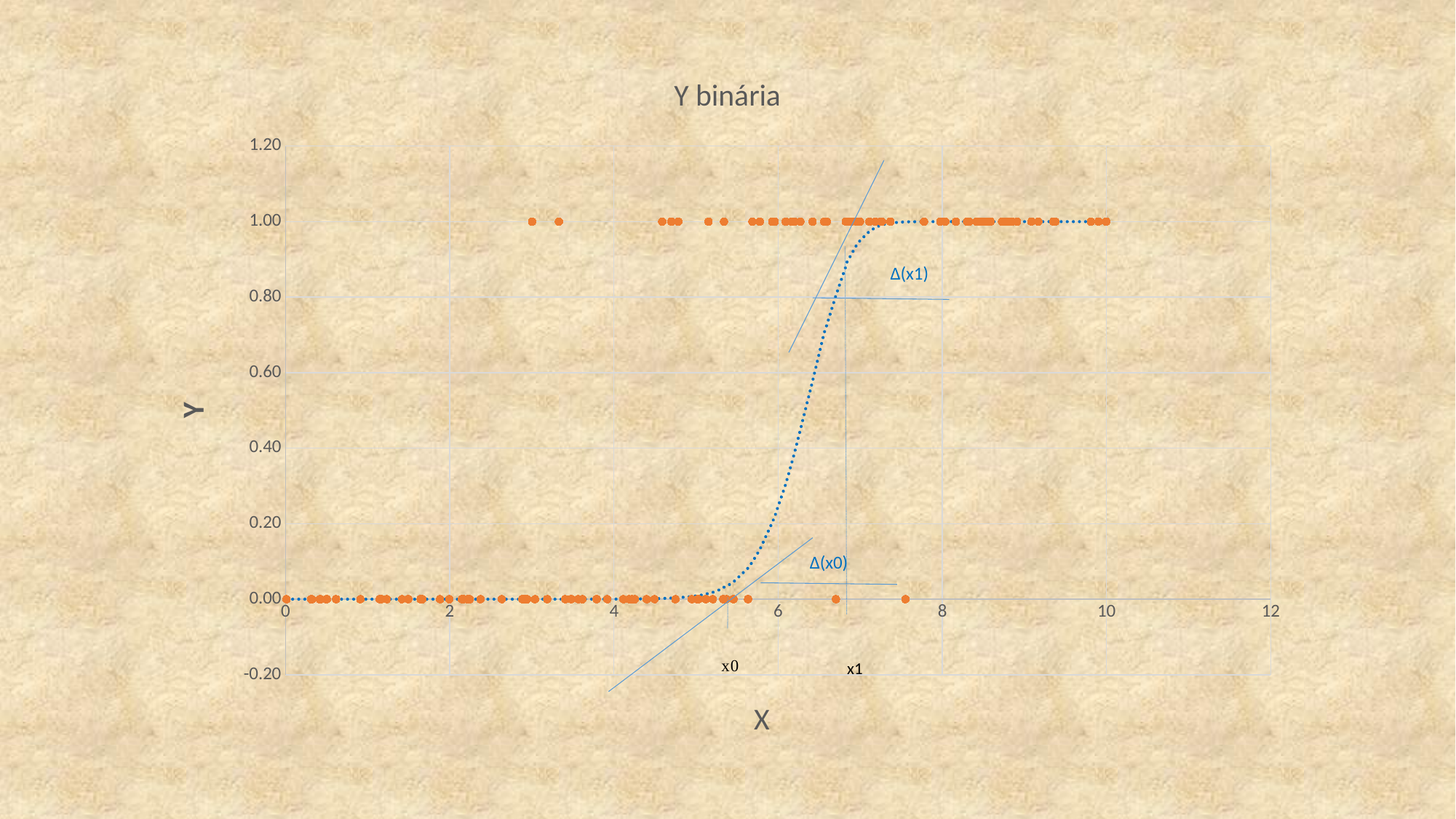
Is the value of the dotted curve at X = 8 greater or less than 0.80? greater What is the label of the horizontal axis? X What is the lowest tick value shown on the vertical axis? -0.20 Is the value of the dotted curve at X = 6 greater or less than 0.40? less What is the largest tick value shown on the horizontal axis? 12 What is the title of the chart? Y binária What kind of chart is shown on the slide? scatter chart At which two Y values do the orange data points lie? 0.00 and 1.00 What is the highest tick value shown on the vertical axis? 1.20 Does the dotted fitted curve rise or fall as X increases? rises Which of the two marked points on the horizontal axis, x0 or x1, is further to the right? x1 Is the value of the dotted curve at X = 4 greater or less than 0.20? less